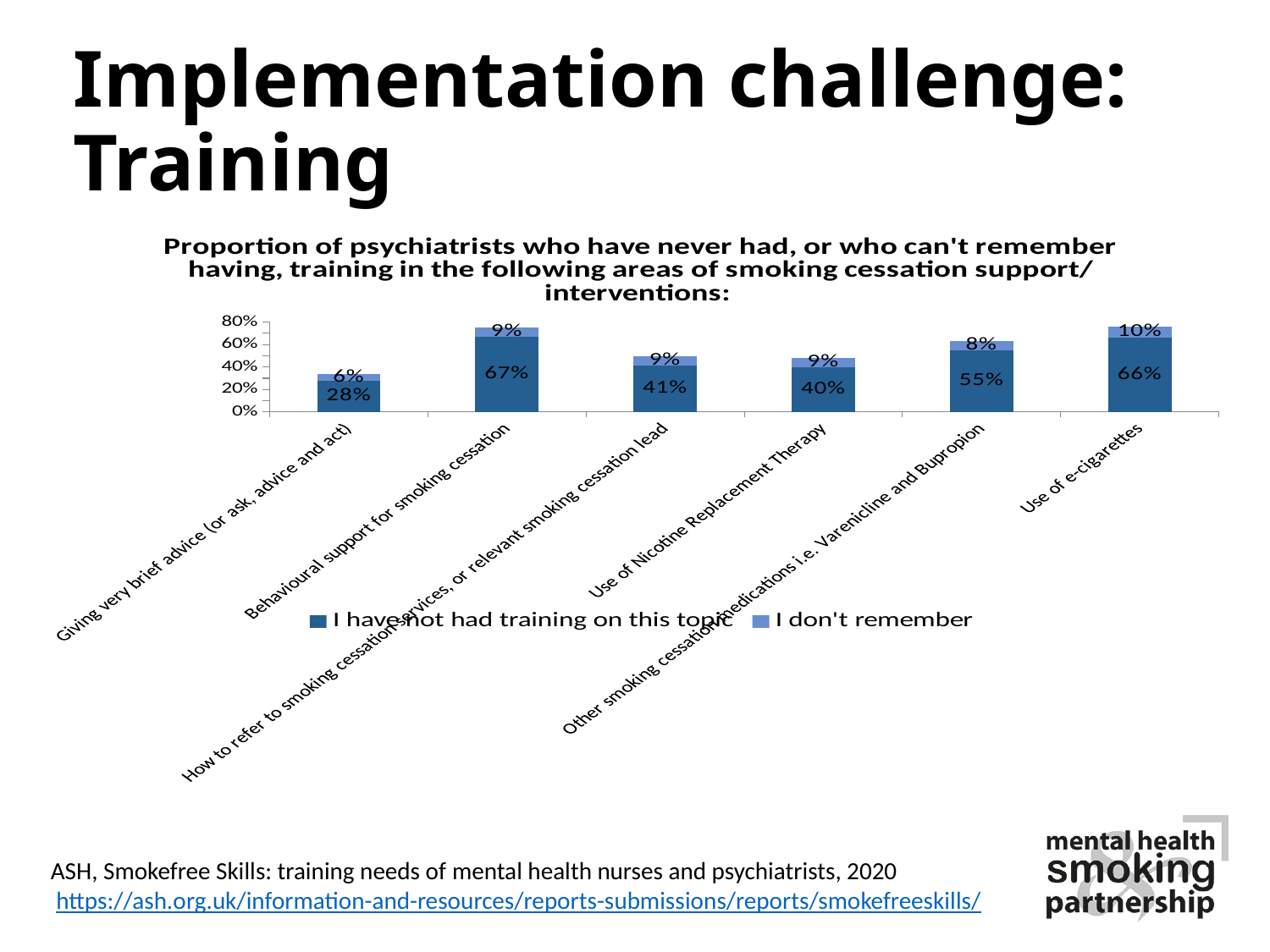
How many categories are shown on the x axis of the chart? 6 What is the difference between the 'I have not had training on this topic' values for Use of e-cigarettes and Giving very brief advice (or ask, advice and act)? 38% Which is larger: the 'I have not had training on this topic' value for Other smoking cessation medications i.e. Varenicline and Bupropion or for How to refer to smoking cessation services, or relevant smoking cessation lead? Other smoking cessation medications i.e. Varenicline and Bupropion How many series does the chart legend list? 2 What is the value of 'I have not had training on this topic' for Behavioural support for smoking cessation? 67% Which category has the highest value for 'I don't remember'? Use of e-cigarettes What is the value of 'I don't remember' for Use of e-cigarettes? 10% What is the total of the stacked bar for Other smoking cessation medications i.e. Varenicline and Bupropion? 63% What type of chart is shown on the slide? Stacked bar chart What is the value of 'I have not had training on this topic' for Use of Nicotine Replacement Therapy? 40% What are the two series named in the chart legend? I have not had training on this topic; I don't remember Which category has the lowest value for 'I have not had training on this topic'? Giving very brief advice (or ask, advice and act)